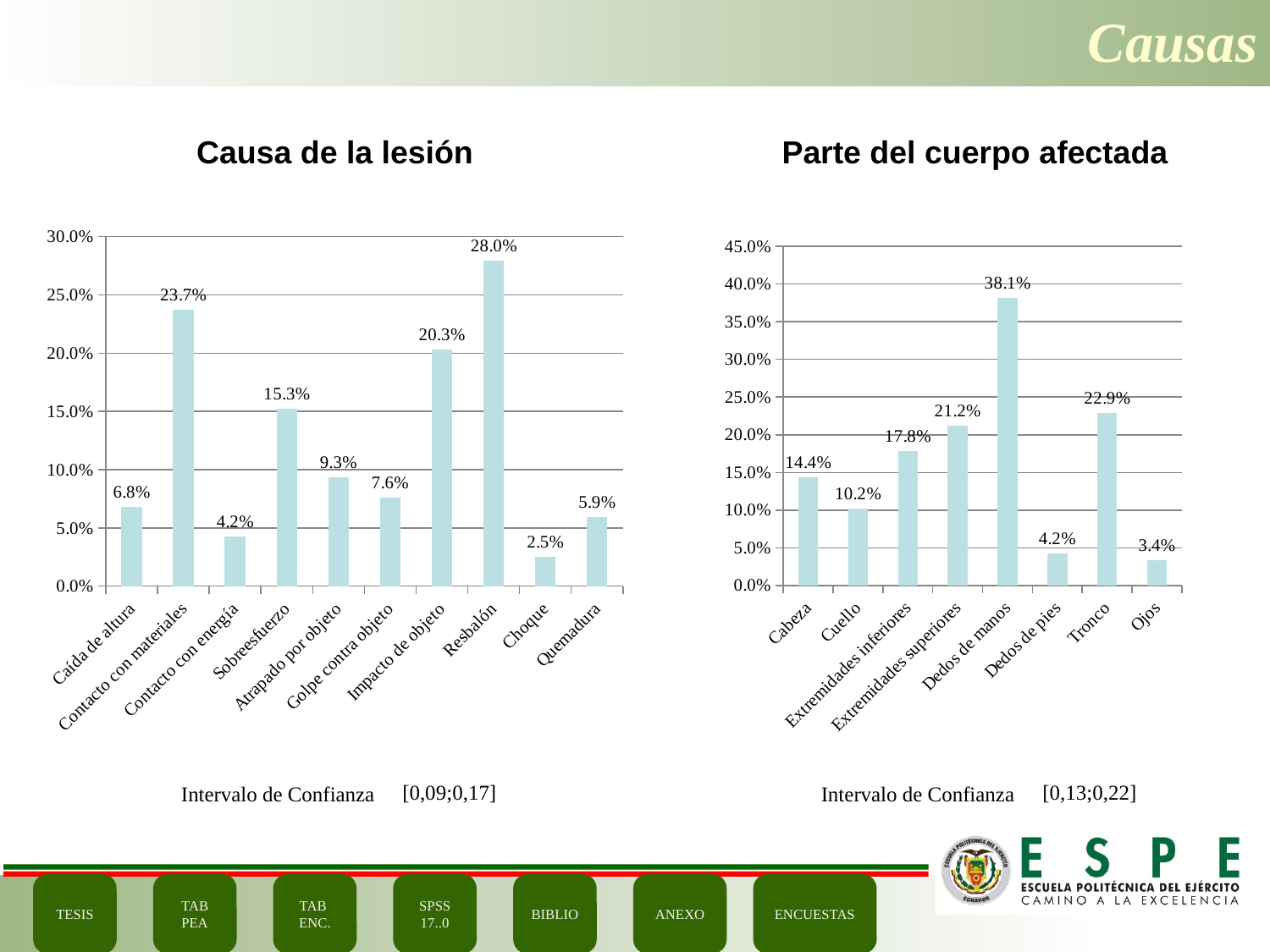
In the 'Parte del cuerpo afectada' chart, which category has the highest value? Dedos de manos In the 'Parte del cuerpo afectada' chart, what is the difference between Extremidades superiores and Extremidades inferiores? 3.4% In the 'Causa de la lesión' chart, what is the value for Resbalón? 28.0% In the 'Causa de la lesión' chart, what is the value for Quemadura? 5.9% In the 'Causa de la lesión' chart, what is the difference between Contacto con materiales and Impacto de objeto? 3.4% What type of chart is the 'Parte del cuerpo afectada' chart? Bar chart In the 'Parte del cuerpo afectada' chart, what is the value for Tronco? 22.9% In the 'Causa de la lesión' chart, which category has the lowest value? Choque In the 'Parte del cuerpo afectada' chart, which is larger, Cabeza or Cuello? Cabeza In the 'Parte del cuerpo afectada' chart, how many categories are shown? 8 In the 'Causa de la lesión' chart, how many categories are shown on the x axis? 10 In the 'Causa de la lesión' chart, which is larger, Sobreesfuerzo or Atrapado por objeto? Sobreesfuerzo